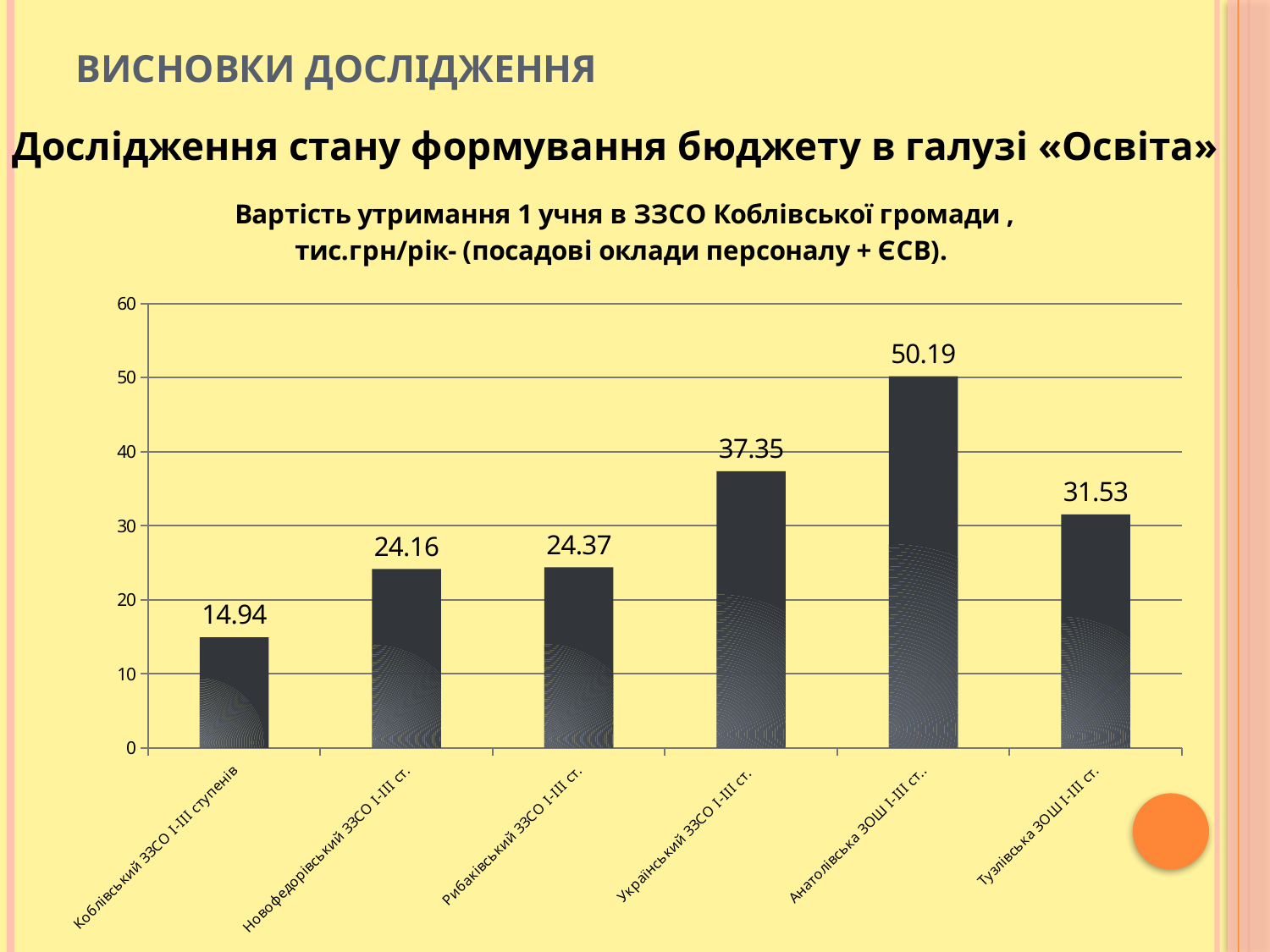
Which is larger, the value for Новофедорівський ЗЗСО І-ІІІ ст. or the value for Тузлівська ЗОШ І-ІІІ ст.? Тузлівська ЗОШ І-ІІІ ст. What is the value for Анатолівська ЗОШ І-ІІІ ст.? 50.19 Is the value for Рибаківський ЗЗСО І-ІІІ ст. greater or less than 30? less How many schools are shown on the chart? 6 What kind of chart is shown on the slide? bar chart What is the difference between the values for Анатолівська ЗОШ І-ІІІ ст. and Коблівський ЗЗСО І-ІІІ ступенів? 35.25 Which school has the lowest cost per pupil? Коблівський ЗЗСО І-ІІІ ступенів Which school has the highest cost per pupil? Анатолівська ЗОШ І-ІІІ ст. What is the value for Тузлівська ЗОШ І-ІІІ ст.? 31.53 What is the value for Український ЗЗСО І-ІІІ ст.? 37.35 What is the value for Коблівський ЗЗСО І-ІІІ ступенів? 14.94 What is the difference between the values for Український ЗЗСО І-ІІІ ст. and Тузлівська ЗОШ І-ІІІ ст.? 5.82